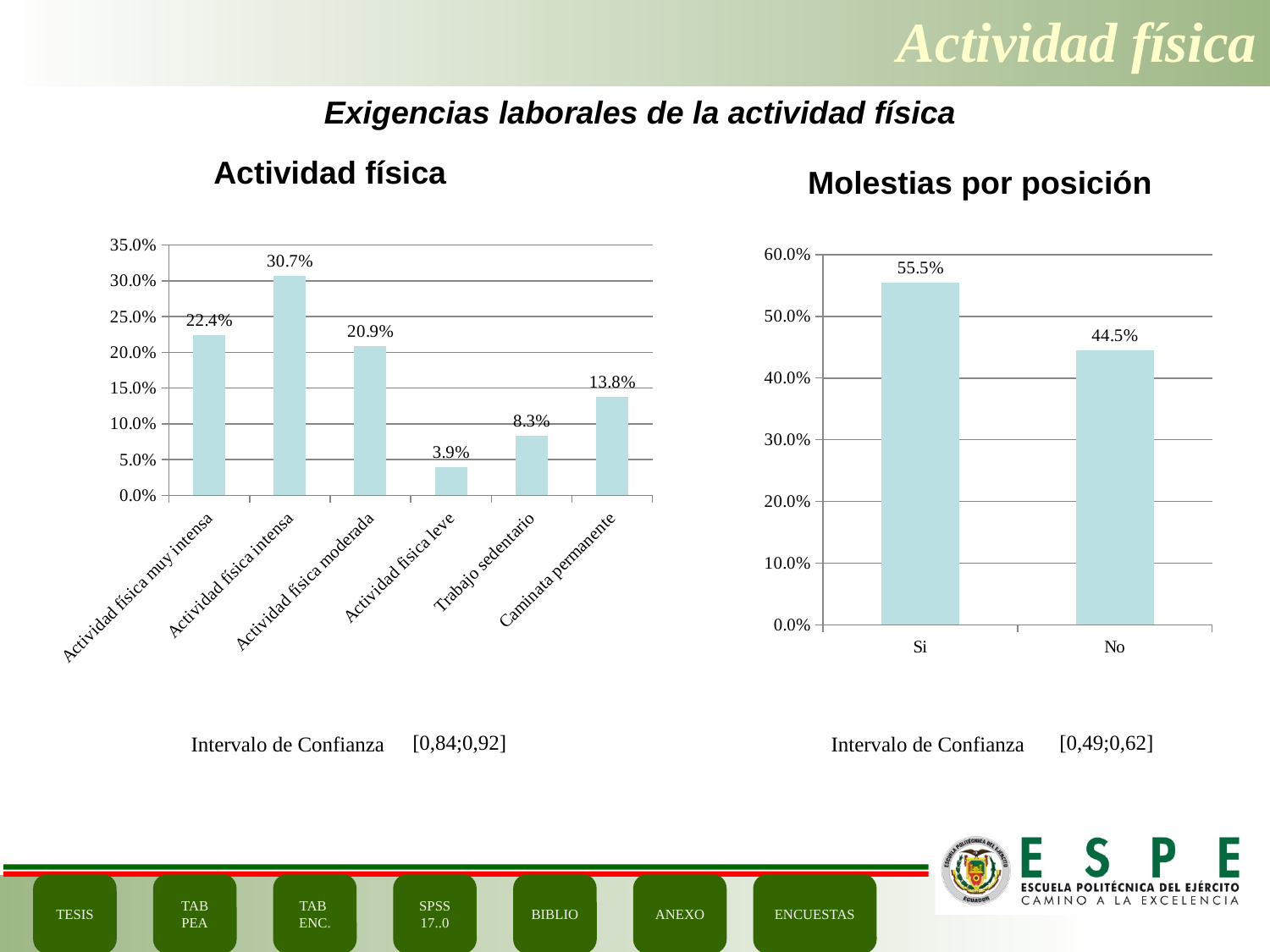
What is the title of the chart on the right side of the slide? Molestias por posición In the 'Actividad física' chart, what is the value for Trabajo sedentario? 8.3% In the 'Actividad física' chart, which is larger: Caminata permanente or Trabajo sedentario? Caminata permanente In the 'Actividad física' chart, what is the value for Actividad física intensa? 30.7% In the 'Actividad física' chart, which category has the highest value? Actividad física intensa In the 'Actividad física' chart, what is the difference between Actividad física muy intensa and Actividad física moderada? 1.5% In the 'Molestias por posición' chart, what is the value for Si? 55.5% In the 'Molestias por posición' chart, is the value for No greater or less than 50.0%? less How many categories are shown in the 'Actividad física' chart? 6 In the 'Actividad física' chart, which category has the lowest value? Actividad física leve In the 'Molestias por posición' chart, what is the difference between Si and No? 11.0% What kind of chart is the 'Molestias por posición' chart? Bar chart